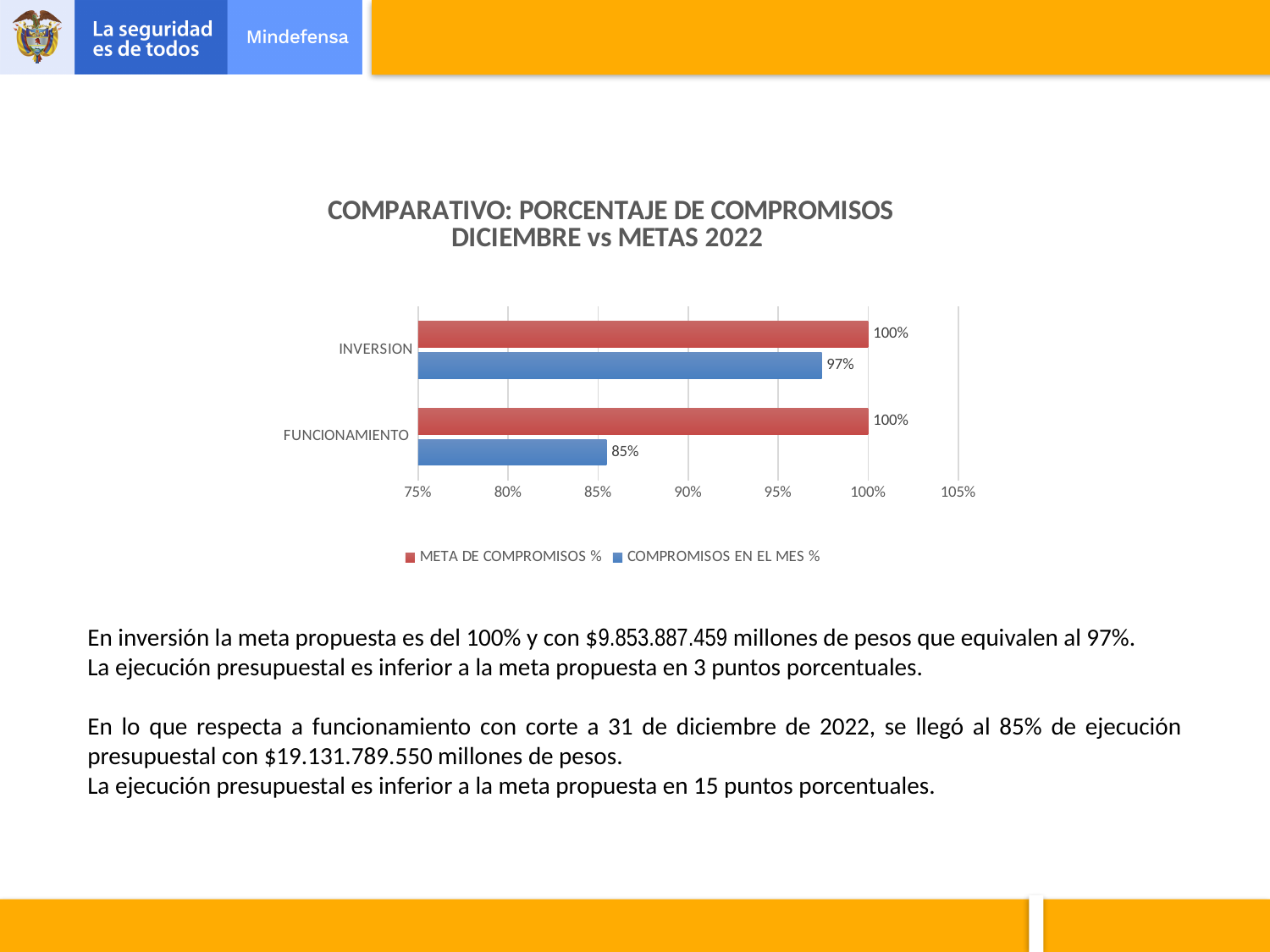
What is the META DE COMPROMISOS % value for INVERSION? 100% What is the COMPROMISOS EN EL MES % value for FUNCIONAMIENTO? 85% What is the difference between the META DE COMPROMISOS % and COMPROMISOS EN EL MES % values for FUNCIONAMIENTO? 15% What is the difference between the META DE COMPROMISOS % and COMPROMISOS EN EL MES % values for INVERSION? 3% How many series does the legend list? 2 Which category has the highest COMPROMISOS EN EL MES % value? INVERSION What is the META DE COMPROMISOS % value for FUNCIONAMIENTO? 100% Which is larger: the COMPROMISOS EN EL MES % value for INVERSION or for FUNCIONAMIENTO? INVERSION Which category has the lowest COMPROMISOS EN EL MES % value? FUNCIONAMIENTO What is the COMPROMISOS EN EL MES % value for INVERSION? 97% How many categories are shown on the chart? 2 What kind of chart is shown on the slide? Bar chart